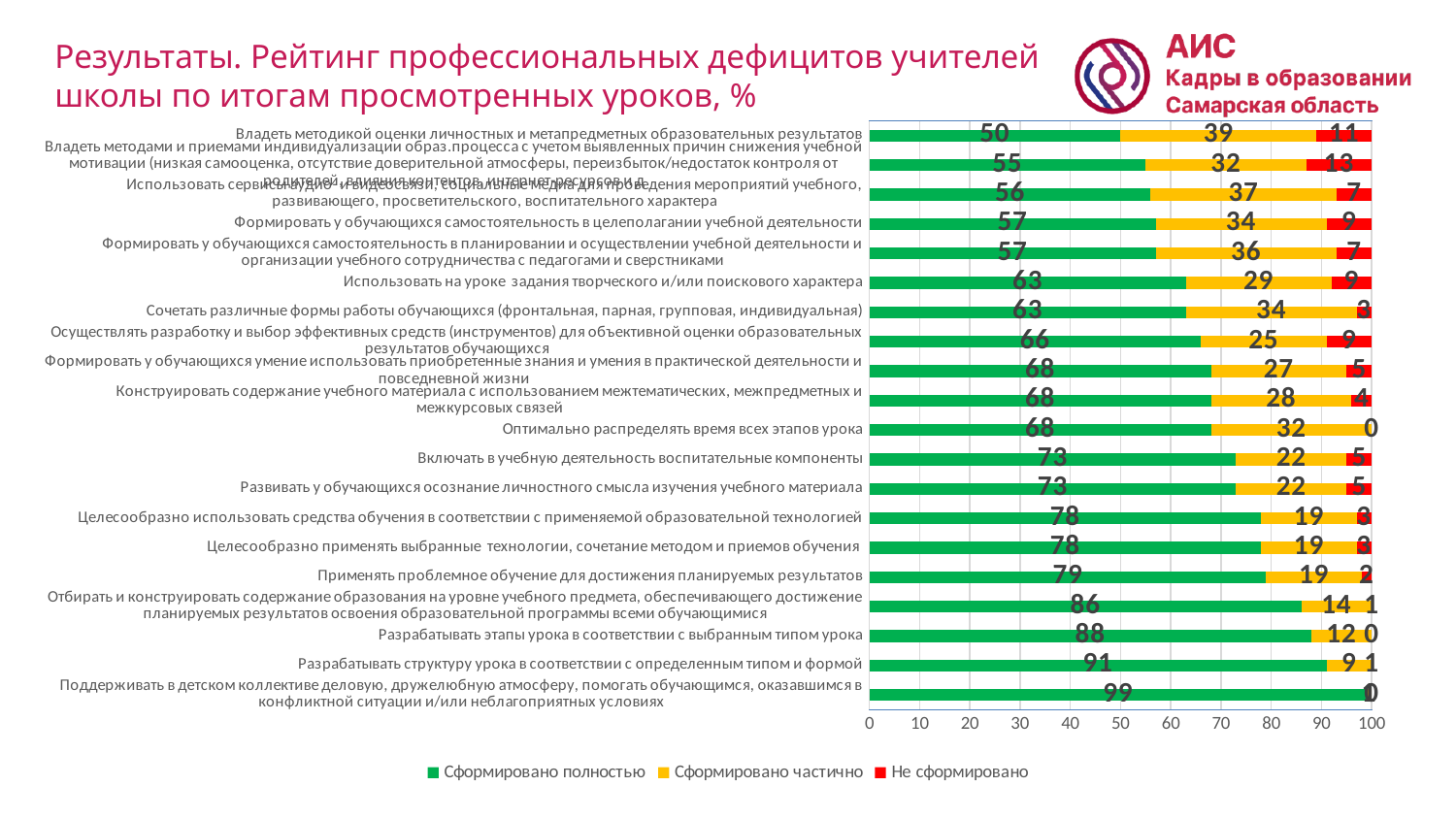
What is the value of "Не сформировано" for "Владеть методикой оценки личностных и метапредметных образовательных результатов"? 11 Which category has the lowest value for "Сформировано полностью"? Владеть методикой оценки личностных и метапредметных образовательных результатов Which category has the highest value for "Не сформировано"? Владеть методами и приемами индивидуализации образ.процесса с учетом выявленных причин снижения учебной мотивации What colour represents "Не сформировано" in the legend? Red Which category has the highest value for "Сформировано полностью"? Поддерживать в детском коллективе деловую, дружелюбную атмосферу, помогать обучающимся, оказавшимся в конфликтной ситуации и/или неблагоприятных условиях What kind of chart is shown on the slide? Stacked bar chart What is the difference in "Сформировано полностью" between "Разрабатывать этапы урока в соответствии с выбранным типом урока" and "Владеть методикой оценки личностных и метапредметных образовательных результатов"? 38 How many series does the legend list? 3 What is the value of "Сформировано частично" for "Разрабатывать этапы урока в соответствии с выбранным типом урока"? 12 Which has a larger "Сформировано частично" value: "Использовать на уроке задания творческого и/или поискового характера" or "Сочетать различные формы работы обучающихся"? Сочетать различные формы работы обучающихся How many categories are shown in the chart? 20 What is the value of "Сформировано полностью" for "Оптимально распределять время всех этапов урока"? 68